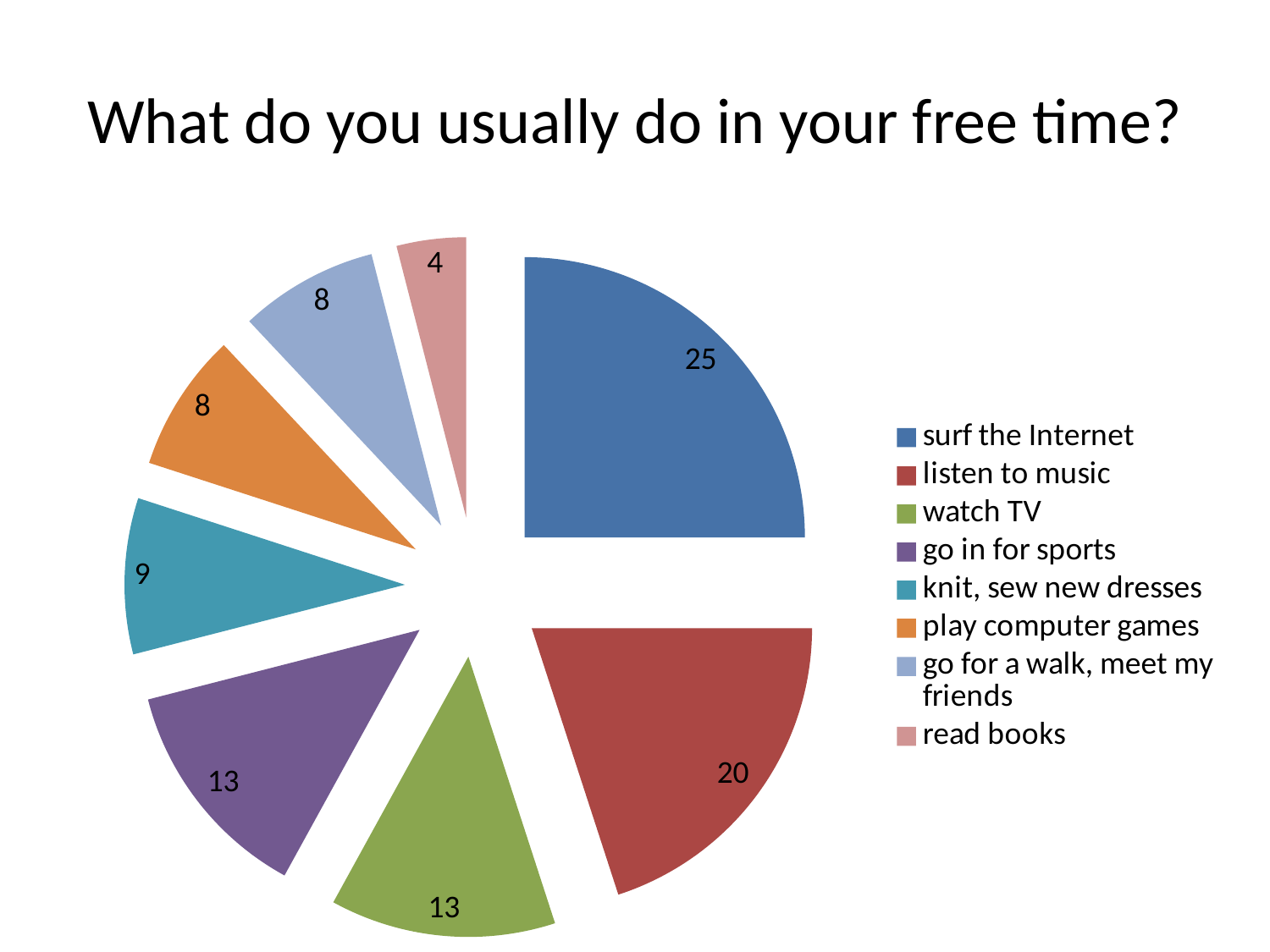
What is the difference between the values for 'surf the Internet' and 'listen to music'? 5 Which activity has the largest slice of the pie? surf the Internet What is the value for 'knit, sew new dresses'? 9 Which activity has the smallest slice of the pie? read books What is the value for 'read books'? 4 What share of the whole pie does 'surf the Internet' represent? 25% What is the value for 'listen to music'? 20 Which is larger, the value for 'go in for sports' or the value for 'play computer games'? go in for sports What is the value for 'surf the Internet'? 25 What type of chart is shown on the slide? pie chart How many slices does the pie chart have? 8 What is the title of the slide? What do you usually do in your free time?